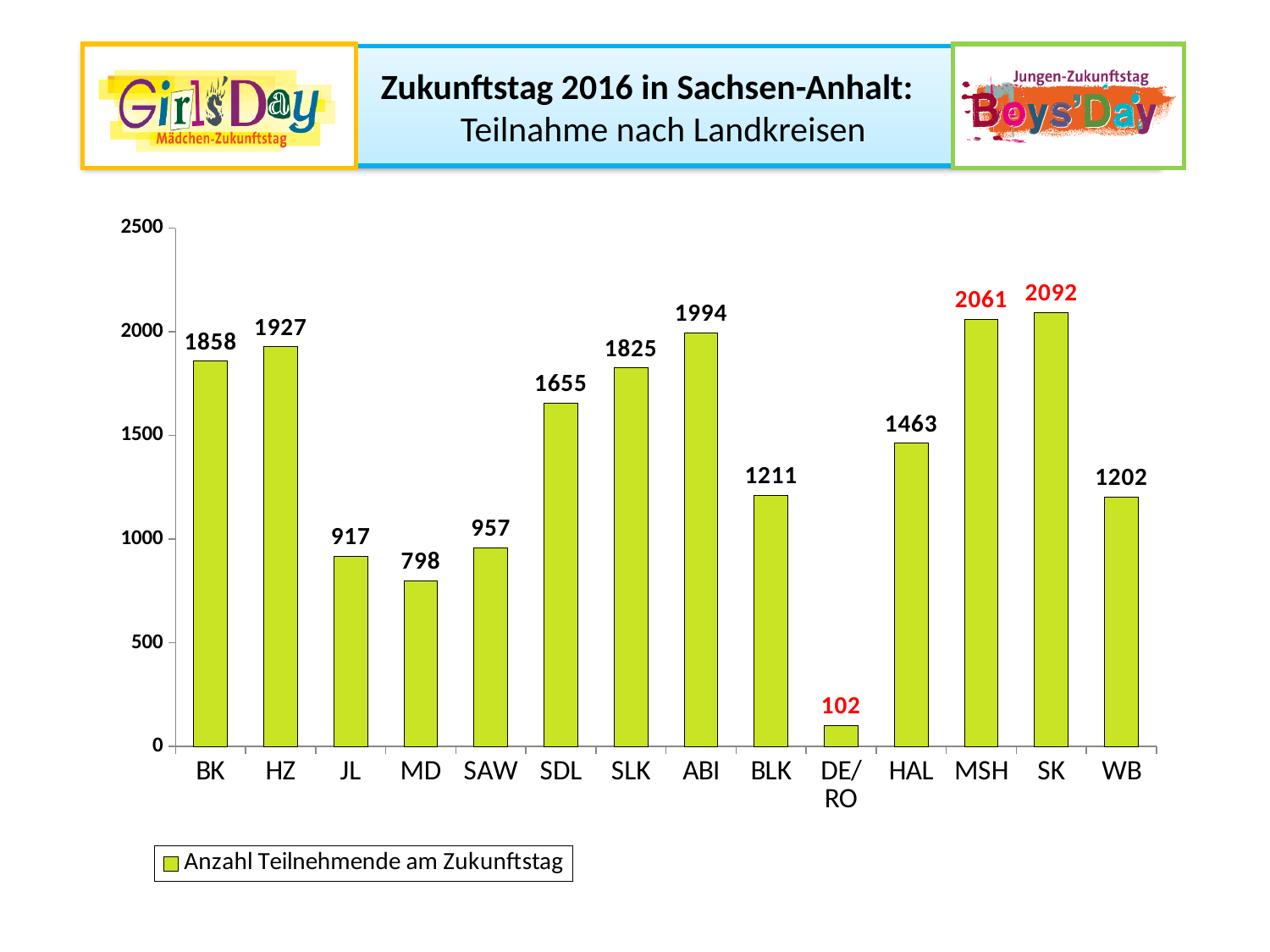
How many series does the legend list? 1 What is the value for HAL? 1463 What kind of chart is shown? bar chart Which category has the highest value? SK Which is larger, the value for HZ or the value for SLK? HZ How many categories are shown on the x axis? 14 What is the value for SDL? 1655 What is the difference between the values for SK and MSH? 31 Which category has the lowest value? DE/RO What is the difference between the values for ABI and BLK? 783 What is the value for DE/RO? 102 What is the legend entry for the series? Anzahl Teilnehmende am Zukunftstag